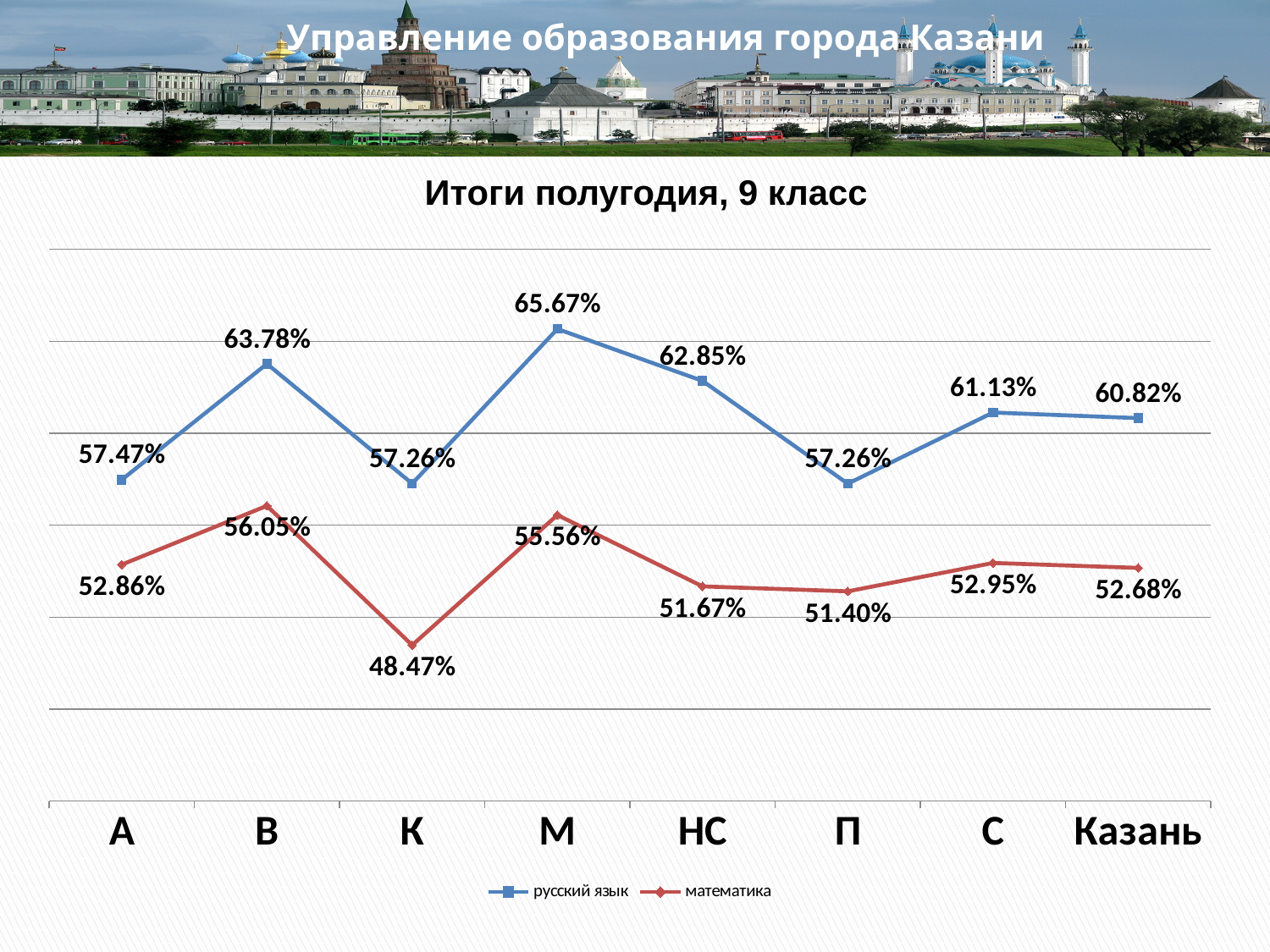
What type of chart is shown on the slide? line chart What is the difference between русский язык and математика in category В? 7.73% Which is larger: математика in category В or математика in category М? В Which category has the lowest value for математика? К How many categories are shown on the x axis? 8 What is the value for математика in category К? 48.47% What is the value for математика for Казань? 52.68% Does the русский язык line rise or fall from НС to П? fall What is the title of the chart? Итоги полугодия, 9 класс How many series does the legend list? 2 What is the value for русский язык in category М? 65.67% Which category has the highest value for русский язык? М